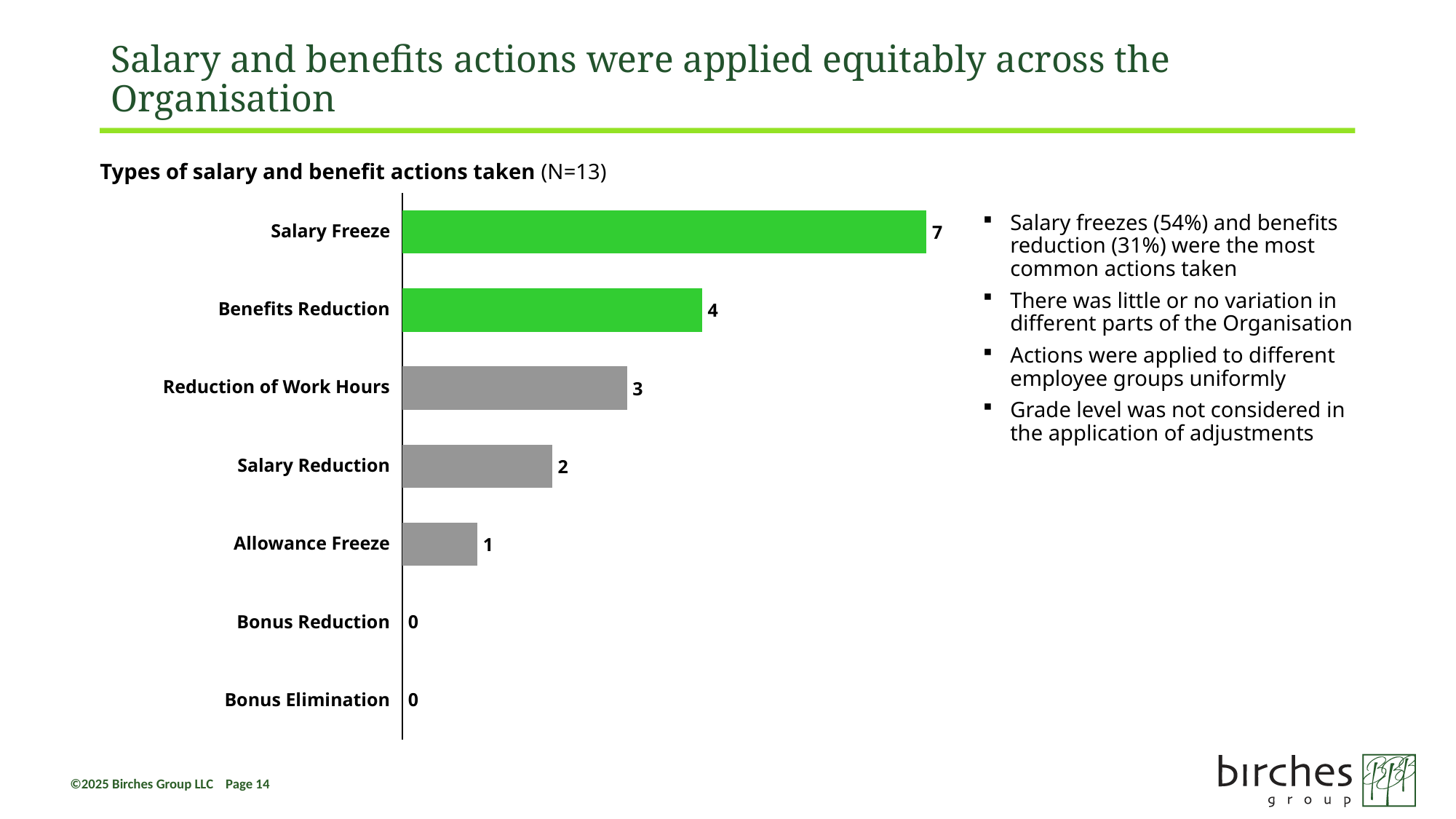
What is the value for Salary Freeze? 7 What is the difference between the values for Salary Freeze and Benefits Reduction? 3 What kind of chart is shown on the slide? Bar chart How many categories are shown in the chart? 7 How many categories have a value of 0? 2 What is the value for Allowance Freeze? 1 Which category has the highest value? Salary Freeze What is the title of the chart? Types of salary and benefit actions taken (N=13) What is the value for Benefits Reduction? 4 Which is larger, the value for Salary Reduction or the value for Reduction of Work Hours? Reduction of Work Hours Which two bars are coloured green? Salary Freeze and Benefits Reduction What is the value for Reduction of Work Hours? 3